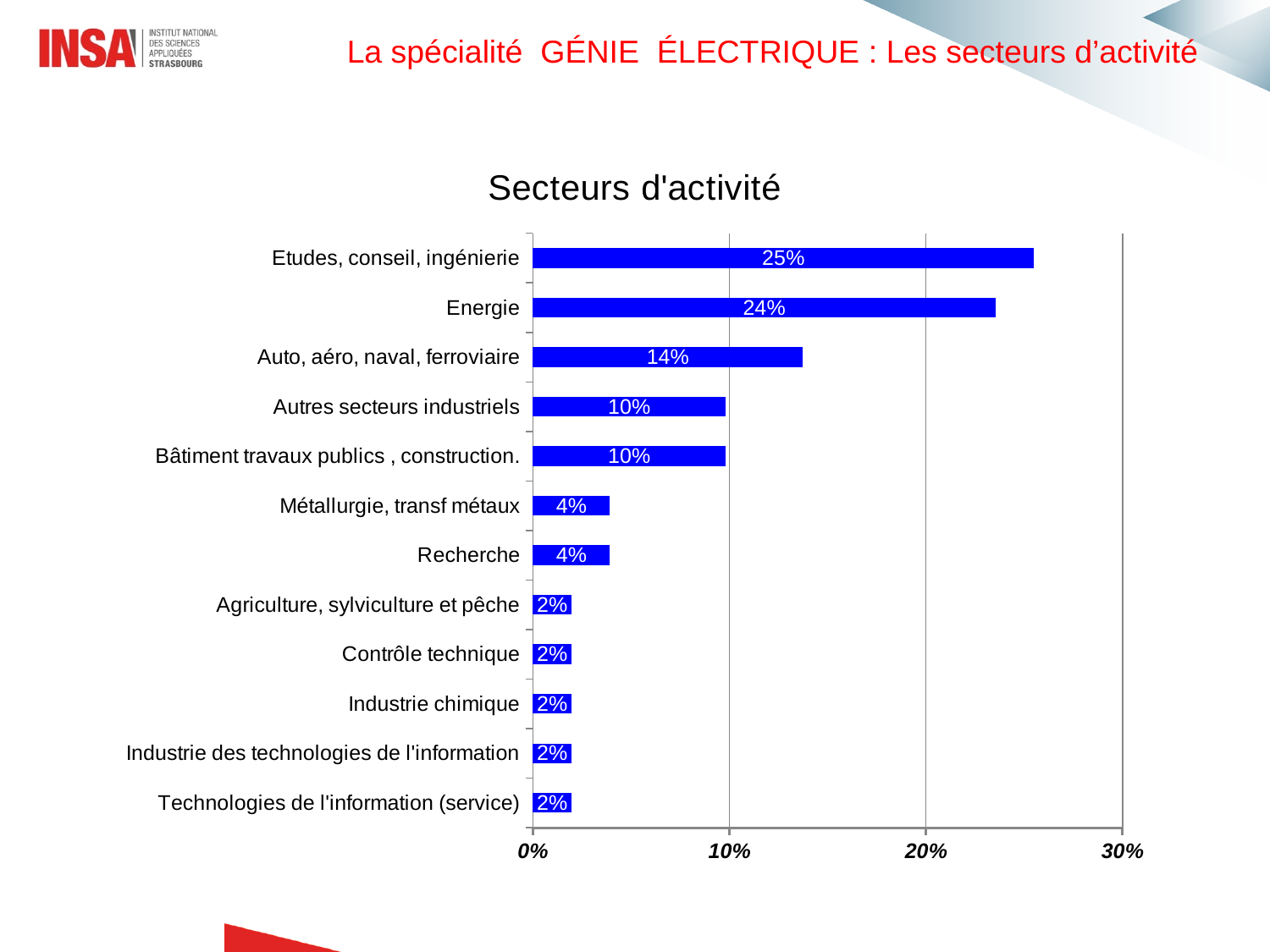
What is the title of the chart? Secteurs d'activité Is the value for Energie greater or less than 20%? greater Which is larger, the value for Auto, aéro, naval, ferroviaire or the value for Bâtiment travaux publics, construction.? Auto, aéro, naval, ferroviaire What is the value for Métallurgie, transf métaux? 4% What is the value for Energie? 24% What is the value for Auto, aéro, naval, ferroviaire? 14% How many categories are shown in the chart? 12 Which category has the highest value? Etudes, conseil, ingénierie What kind of chart is shown on the slide? bar chart What is the difference between the values for Etudes, conseil, ingénierie and Auto, aéro, naval, ferroviaire? 11% What is the difference between the values for Energie and Autres secteurs industriels? 14% What is the value for Industrie chimique? 2%